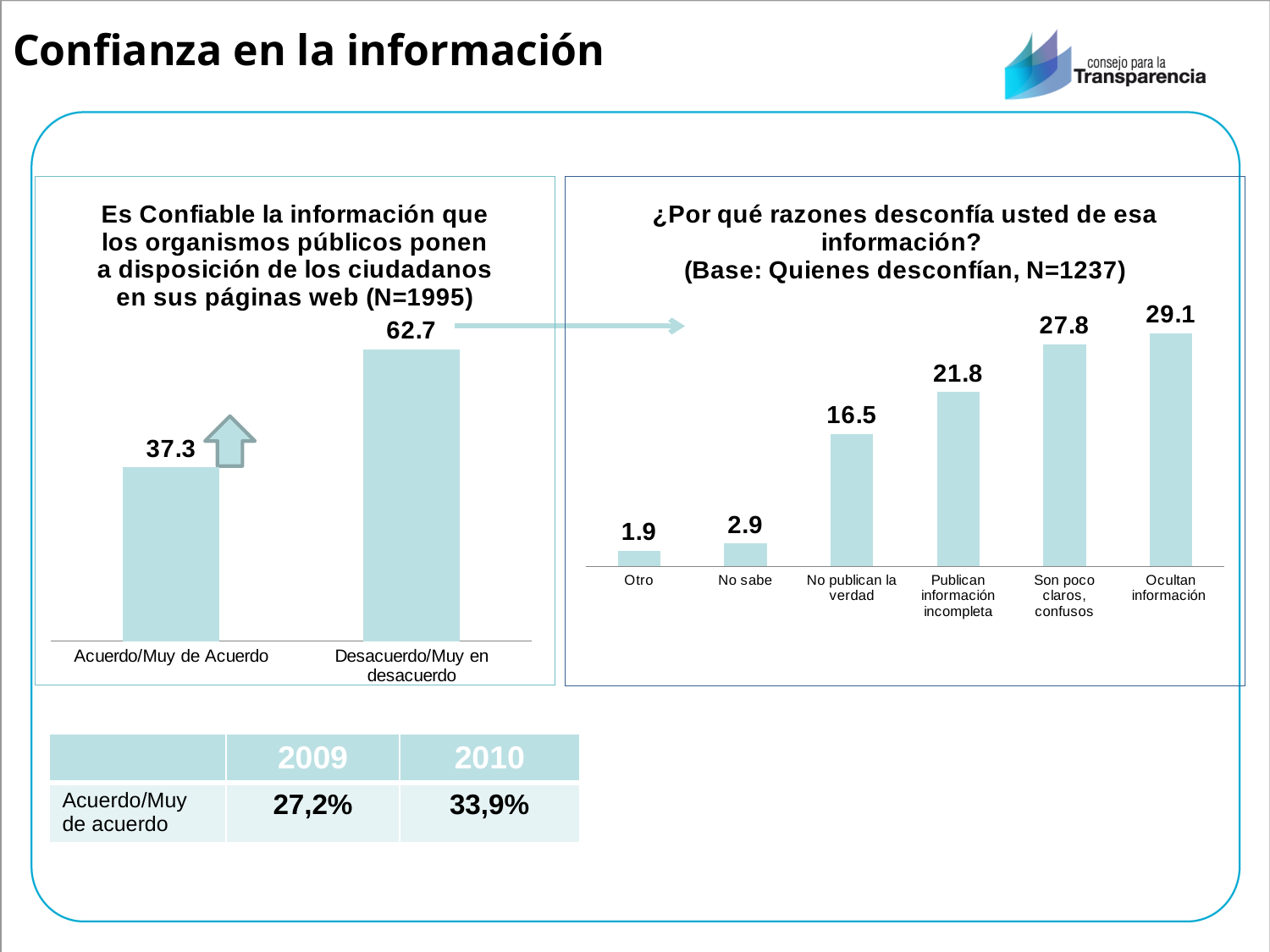
In the right chart (¿Por qué razones desconfía usted de esa información?), how many categories are shown? 6 In the left chart (Es Confiable la información...), what is the value for Desacuerdo/Muy en desacuerdo? 62.7 In the left chart (Es Confiable la información...), what is the value for Acuerdo/Muy de Acuerdo? 37.3 In the left chart (Es Confiable la información...), how many categories are shown? 2 In the right chart (¿Por qué razones desconfía usted de esa información?), what is the value for Publican información incompleta? 21.8 In the right chart (¿Por qué razones desconfía usted de esa información?), what is the value for Ocultan información? 29.1 What kind of chart is the right chart (¿Por qué razones desconfía usted de esa información?)? Bar chart In the right chart (¿Por qué razones desconfía usted de esa información?), which category has the highest value? Ocultan información In the right chart (¿Por qué razones desconfía usted de esa información?), which category has the lowest value? Otro In the left chart (Es Confiable la información...), what is the difference between Desacuerdo/Muy en desacuerdo and Acuerdo/Muy de Acuerdo? 25.4 In the right chart (¿Por qué razones desconfía usted de esa información?), which is larger: No sabe or No publican la verdad? No publican la verdad In the right chart (¿Por qué razones desconfía usted de esa información?), what is the difference between Son poco claros, confusos and No publican la verdad? 11.3